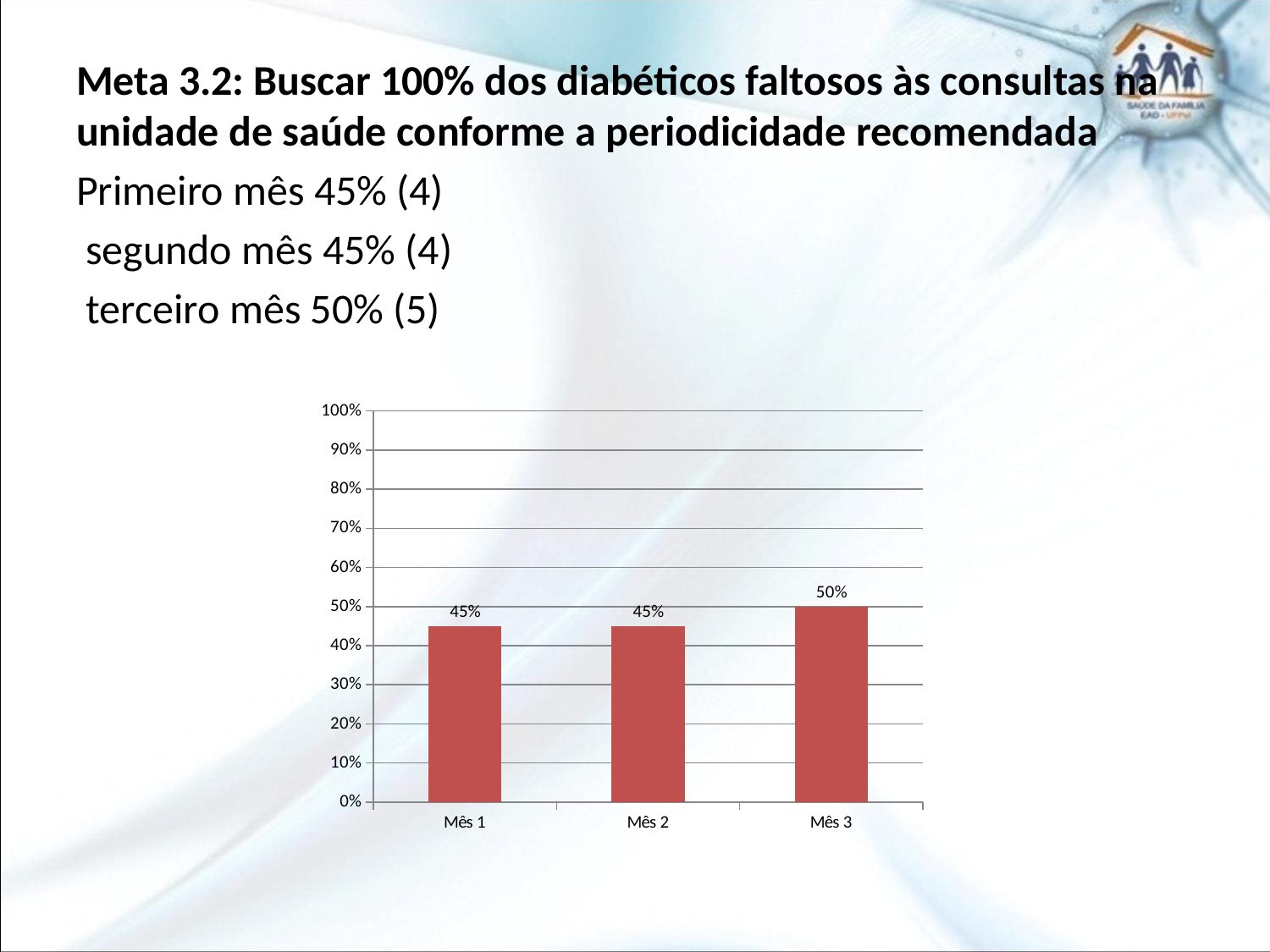
Which month has the highest value? Mês 3 What is the value for Mês 2? 45% What is the value for Mês 3? 50% What is the highest value shown on the y axis? 100% How many categories are shown on the x axis? 3 Is the value for Mês 1 greater or less than 60%? less What is the difference between the values for Mês 3 and Mês 1? 5% Is the value for Mês 3 greater or less than 40%? greater Do the values rise or fall from Mês 2 to Mês 3? rise What kind of chart is shown on the slide? bar chart Which is larger, the value for Mês 3 or the value for Mês 2? Mês 3 What is the value for Mês 1? 45%